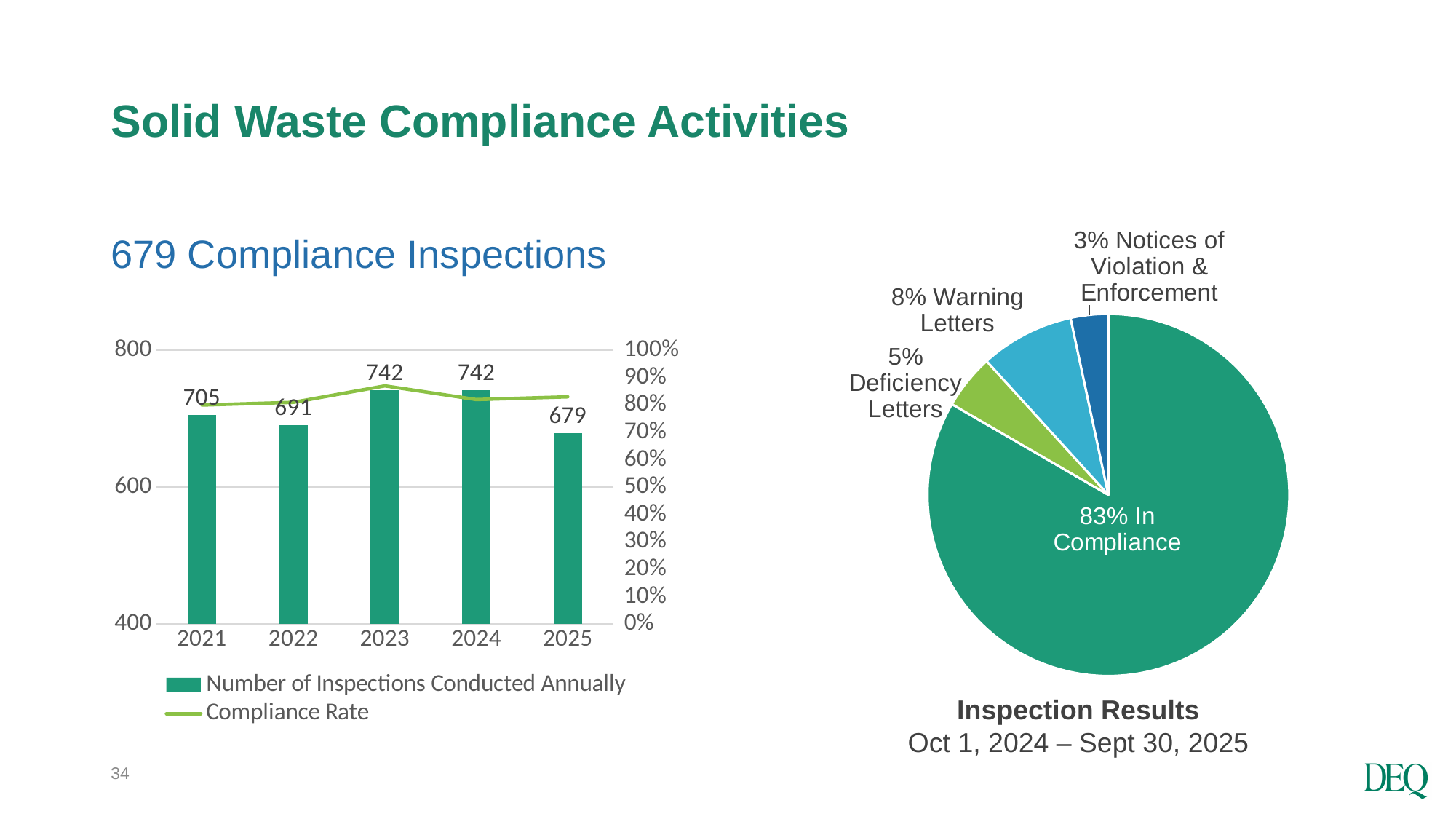
In the chart on the left, how many series does the legend list? 2 In the bar chart on the left, which year had more inspections, 2021 or 2022? 2021 In the chart on the left, is the compliance rate for 2023 greater or less than 70%? greater In the bar chart on the left, how many years are shown on the x axis? 5 In the bar chart on the left, how many inspections were conducted in 2025? 679 In the Inspection Results pie chart, what share of inspections resulted in Warning Letters? 8% In the bar chart on the left, how many inspections were conducted in 2021? 705 What type of chart is the Inspection Results chart on the right? Pie chart In the Inspection Results pie chart, which category has the smallest slice? Notices of Violation & Enforcement In the bar chart on the left, which year had the lowest number of inspections? 2025 In the bar chart on the left, what is the difference in the number of inspections between 2023 and 2025? 63 In the Inspection Results pie chart, what share of inspections were In Compliance? 83%